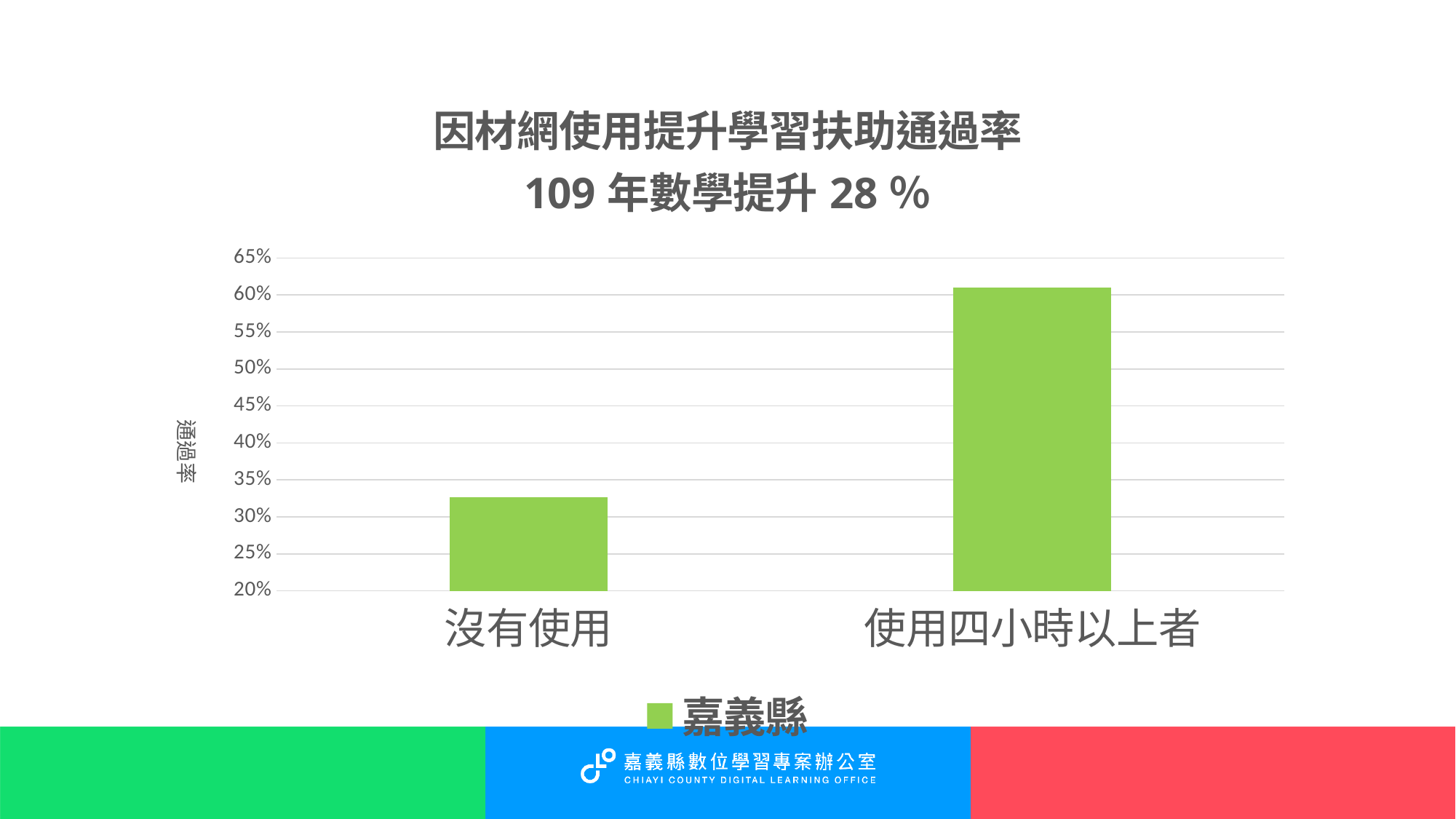
What series name is shown in the chart's legend? 嘉義縣 What is the label on the chart's vertical axis? 通過率 Is the value for 沒有使用 greater or less than 30%? greater Which category has the highest pass rate in the chart? 使用四小時以上者 What kind of chart is shown on the slide? bar chart Which is larger, the value for 沒有使用 or the value for 使用四小時以上者? 使用四小時以上者 Do the values rise or fall from 沒有使用 to 使用四小時以上者? rise Is the value for 沒有使用 greater or less than 35%? less Which category has the lowest pass rate in the chart? 沒有使用 How many categories are shown on the x axis of the chart? 2 Is the value for 使用四小時以上者 greater or less than 55%? greater How many series does the chart's legend list? 1